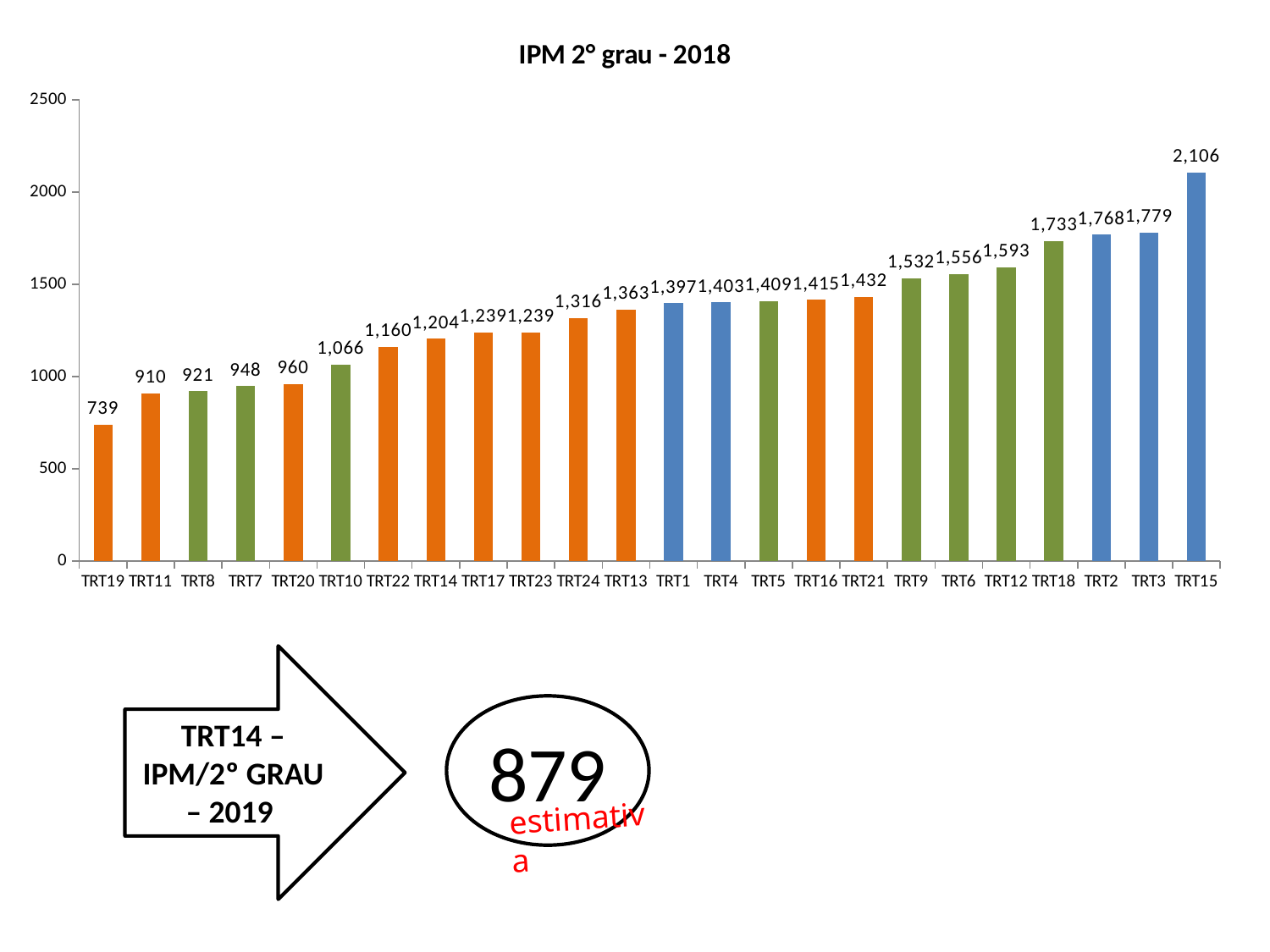
Which category has the lowest value in the chart? TRT19 How many categories are shown in the chart? 24 What is the value for TRT19 in the chart? 739 Do the values rise or fall from left to right along the x axis? Rise Which category has the highest value in the chart? TRT15 What is the difference between the values for TRT3 and TRT2? 11 Which has a larger value, TRT10 or TRT22? TRT22 What kind of chart is shown on the slide? Bar chart What is the value for TRT14 in the chart? 1,204 What is the value for TRT9 in the chart? 1,532 Is the value for TRT18 greater or less than 1500? greater What is the difference between the values for TRT15 and TRT19? 1,367